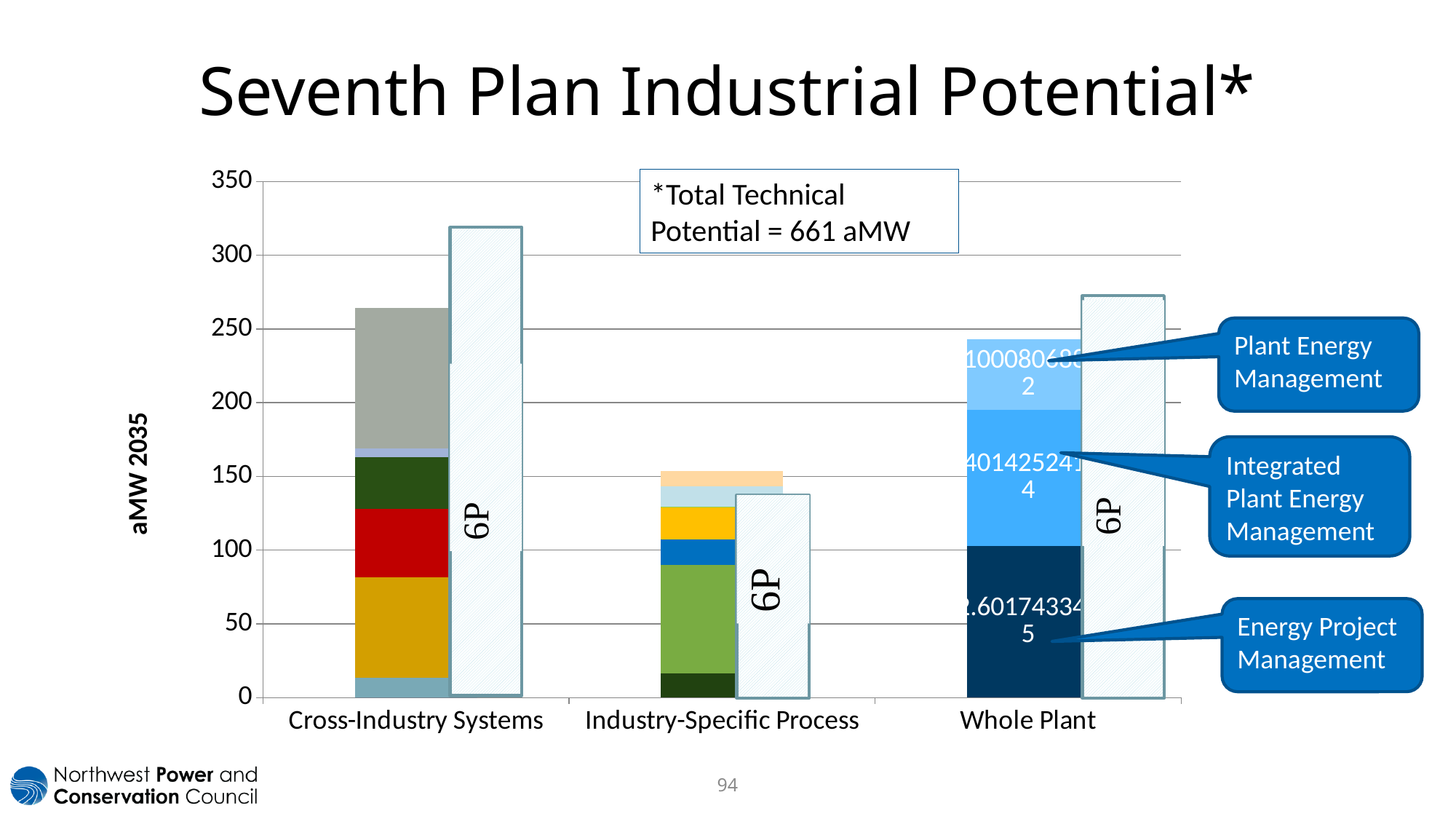
What is the label on the y axis of the chart? aMW 2035 Is the stacked bar for Cross-Industry Systems greater or less than 250? greater Which category has the shortest stacked bar? Industry-Specific Process Is the stacked bar for Industry-Specific Process greater or less than 200? less Which is taller: the stacked bar for Whole Plant or the stacked bar for Industry-Specific Process? Whole Plant Is the 6P bar for Whole Plant greater or less than 250? greater According to the note on the chart, what is the Total Technical Potential? 661 aMW Which category has the tallest 6P bar? Cross-Industry Systems How many categories are shown on the x axis of the chart? 3 For Whole Plant, which is taller: the stacked bar or the 6P bar? The 6P bar What kind of chart is shown on the slide? Stacked bar chart